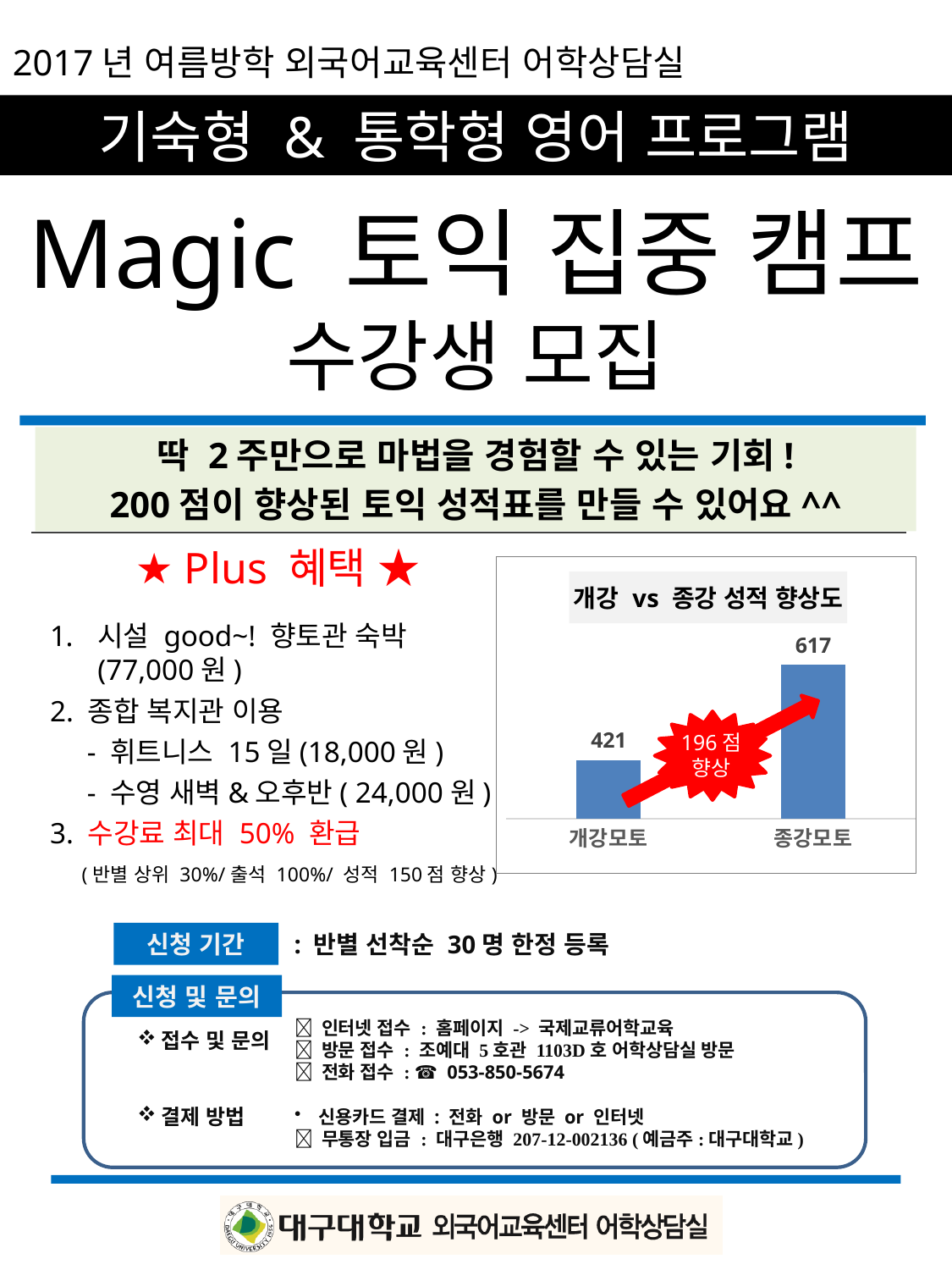
How many categories are shown in the chart? 2 What is the value for 개강모토 in the chart? 421 What is the difference between the values for 종강모토 and 개강모토? 196 What text is written inside the red oval on the chart? 196 점 향상 Which is larger, the value for 개강모토 or the value for 종강모토? 종강모토 What is the value for 종강모토 in the chart? 617 What is the title of the chart? 개강 vs 종강 성적 향상도 Do the values rise or fall from 개강모토 to 종강모토? rise Which category has the lowest value in the chart? 개강모토 What kind of chart is shown on the slide? bar chart Which category has the highest value in the chart? 종강모토